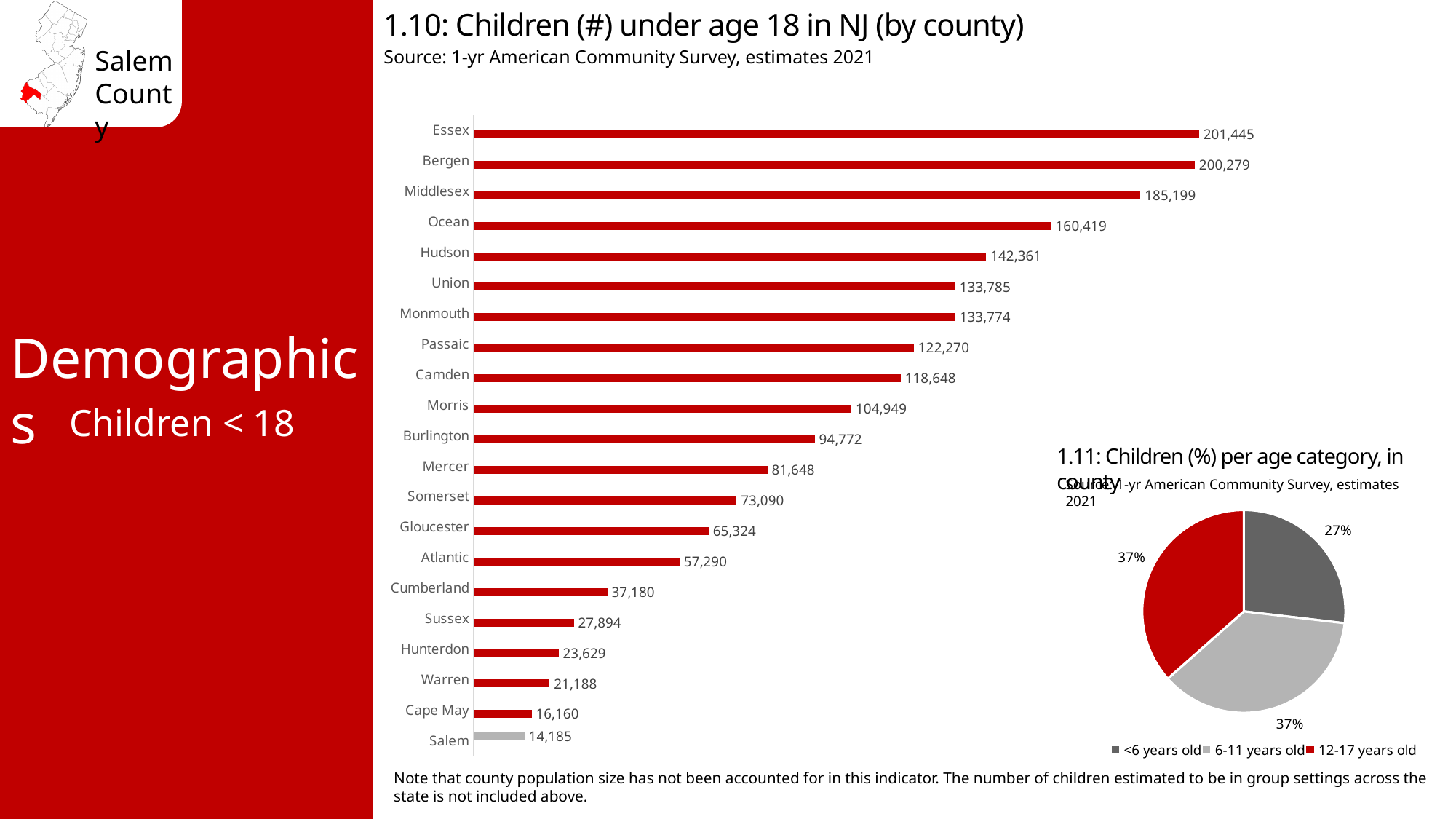
In chart 1.10 (Children under age 18 in NJ by county), what is the value for Gloucester? 65,324 In chart 1.11 (Children per age category in county), what share of children are under 6 years old? 27% In chart 1.10 (Children under age 18 in NJ by county), which county has the highest number of children under 18? Essex In chart 1.10 (Children under age 18 in NJ by county), which county has the lowest number of children under 18? Salem In chart 1.11 (Children per age category in county), which age category has the smallest share? <6 years old In chart 1.10 (Children under age 18 in NJ by county), what is the difference between Cape May and Salem? 1,975 In chart 1.10 (Children under age 18 in NJ by county), how many counties are shown? 21 What type of chart is chart 1.10 (Children under age 18 in NJ by county)? Bar chart In chart 1.10 (Children under age 18 in NJ by county), which has more children under 18, Cumberland or Sussex? Cumberland In chart 1.10 (Children under age 18 in NJ by county), what is the difference between Essex and Bergen? 1,166 In chart 1.11 (Children per age category in county), how many age categories does the legend list? 3 In chart 1.10 (Children under age 18 in NJ by county), how many children under 18 are in Salem County? 14,185